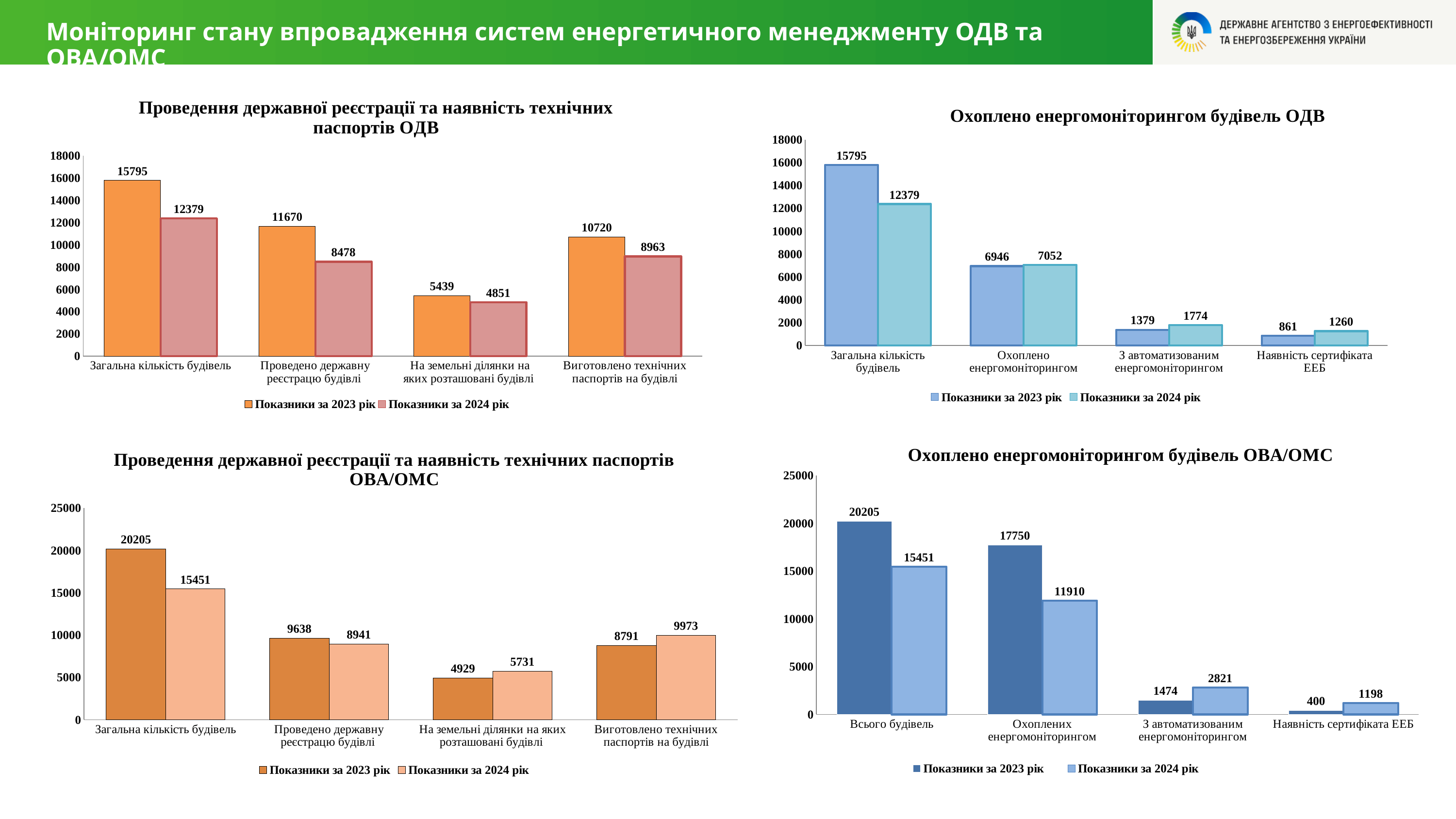
In the chart 'Охоплено енергомоніторингом будівель ОВА/ОМС', what is the value for 'Охоплених енергомоніторингом' in the series 'Показники за 2023 рік'? 17750 In the chart 'Проведення державної реєстрації та наявність технічних паспортів ОДВ', what is the difference between the 2023 and 2024 values for 'Загальна кількість будівель'? 3416 In the chart 'Охоплено енергомоніторингом будівель ОВА/ОМС', what is the difference between the 2024 and 2023 values for 'Наявність сертифіката ЕЕБ'? 798 In the chart 'Проведення державної реєстрації та наявність технічних паспортів ОВА/ОМС', what is the value for 'Виготовлено технічних паспортів на будівлі' in the series 'Показники за 2024 рік'? 9973 In the chart 'Охоплено енергомоніторингом будівель ОДВ', what is the value for 'Наявність сертифіката ЕЕБ' in the series 'Показники за 2024 рік'? 1260 In the chart 'Проведення державної реєстрації та наявність технічних паспортів ОВА/ОМС', which category has the highest value in the series 'Показники за 2023 рік'? Загальна кількість будівель In the chart 'Проведення державної реєстрації та наявність технічних паспортів ОДВ', what is the value for 'Проведено державну реєстрацію будівлі' in the series 'Показники за 2023 рік'? 11670 How many series does the legend list in the chart 'Охоплено енергомоніторингом будівель ОДВ'? 2 What type of chart is 'Охоплено енергомоніторингом будівель ОВА/ОМС'? Bar chart In the chart 'Проведення державної реєстрації та наявність технічних паспортів ОДВ', which category has the lowest value in the series 'Показники за 2024 рік'? На земельні ділянки на яких розташовані будівлі In the chart 'Охоплено енергомоніторингом будівель ОДВ', which is larger for 'З автоматизованим енергомоніторингом': the 2023 value or the 2024 value? 2024 value (1774) How many categories are shown on the x axis of the chart 'Проведення державної реєстрації та наявність технічних паспортів ОВА/ОМС'? 4